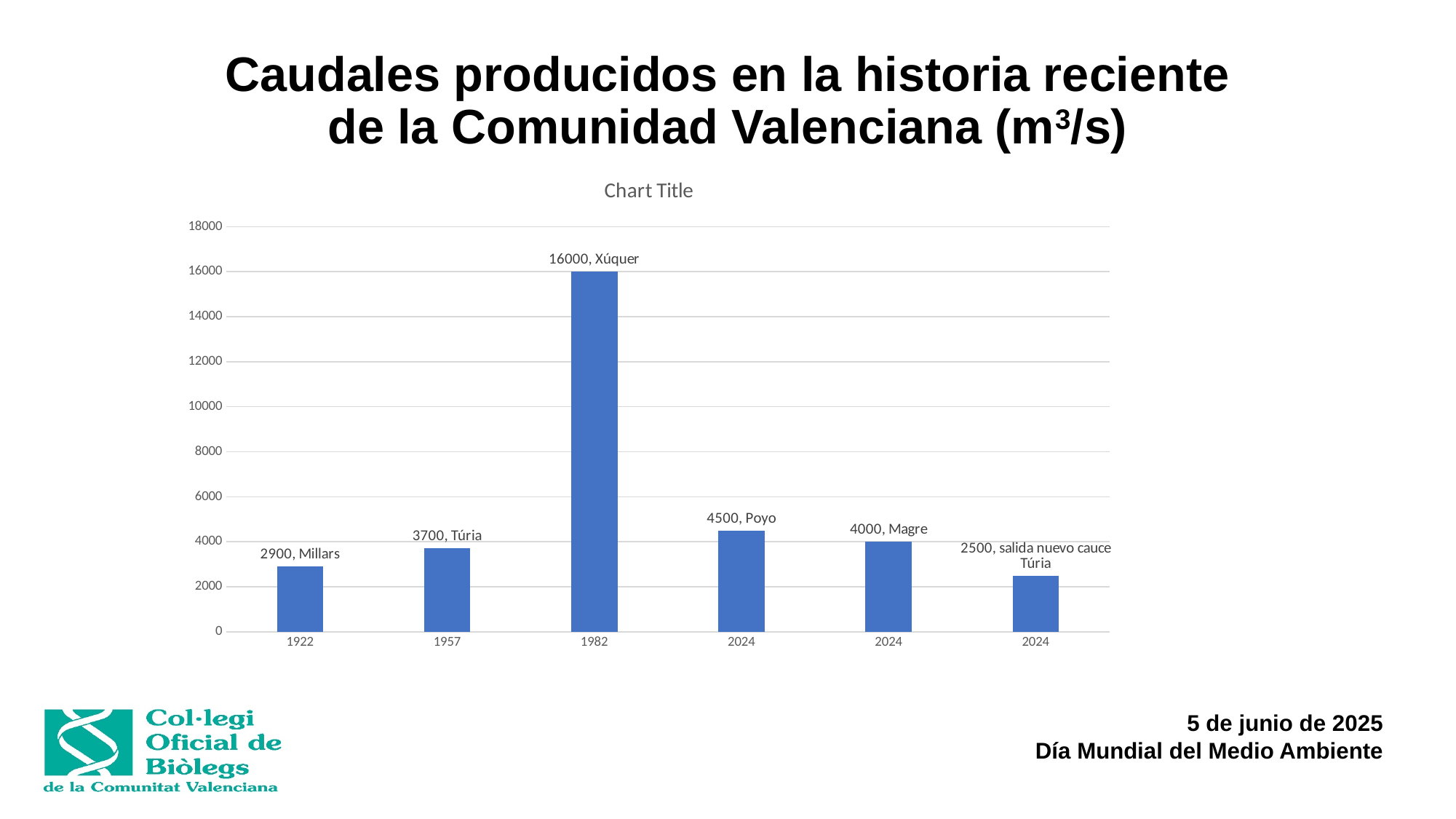
What is the value for Millars (1922)? 2900 How many bars are plotted in the chart? 6 What is the value for Magre (2024)? 4000 What is the difference between the Túria (1957) value and the Millars (1922) value? 800 What is the value for Xúquer (1982)? 16000 Which bar has the lowest value? salida nuevo cauce Túria (2024) What kind of chart is shown on the slide? Bar chart What is the value for Poyo (2024)? 4500 What is the placeholder title shown above the chart? Chart Title Which bar has the highest value? Xúquer (1982) What is the difference between the Xúquer value and the Poyo value? 11500 Which is larger, the value for Poyo or the value for Magre? Poyo